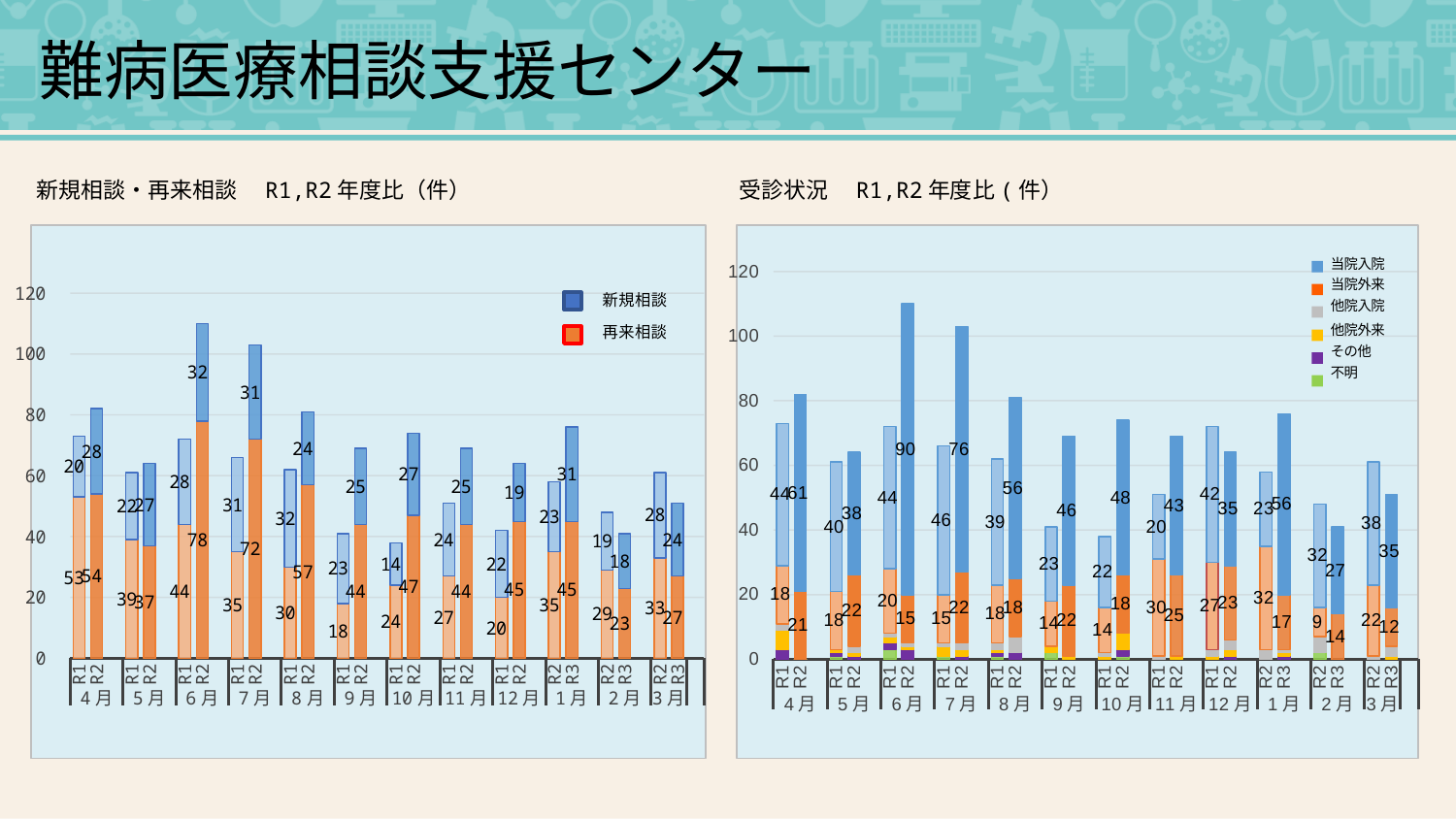
In the left chart (新規相談・再来相談), what is the difference between the 再来相談 values for 6月 R2 and 6月 R1? 34 In the right chart (受診状況), is the total of the 6月 R2 bar greater or less than 100? greater In the right chart (受診状況), what is the 当院入院 value for 6月 R2? 90 In the left chart (新規相談・再来相談), what is the 再来相談 value for 6月 R2? 78 What kind of chart is the left chart titled 新規相談・再来相談 R1,R2 年度比（件）? stacked bar chart In the left chart (新規相談・再来相談), which bar is the tallest overall? 6月 R2 In the left chart (新規相談・再来相談), what is the total of the stacked bar for 6月 R2? 110 How many series does the legend of the left chart (新規相談・再来相談) list? 2 In the left chart (新規相談・再来相談), which has the larger 再来相談 value, 9月 R1 or 9月 R2? 9月 R2 In the left chart (新規相談・再来相談), which bar has the lowest 新規相談 value? 10月 R1 How many series does the legend of the right chart (受診状況) list? 6 In the left chart (新規相談・再来相談), what is the 新規相談 value for 7月 R2? 31